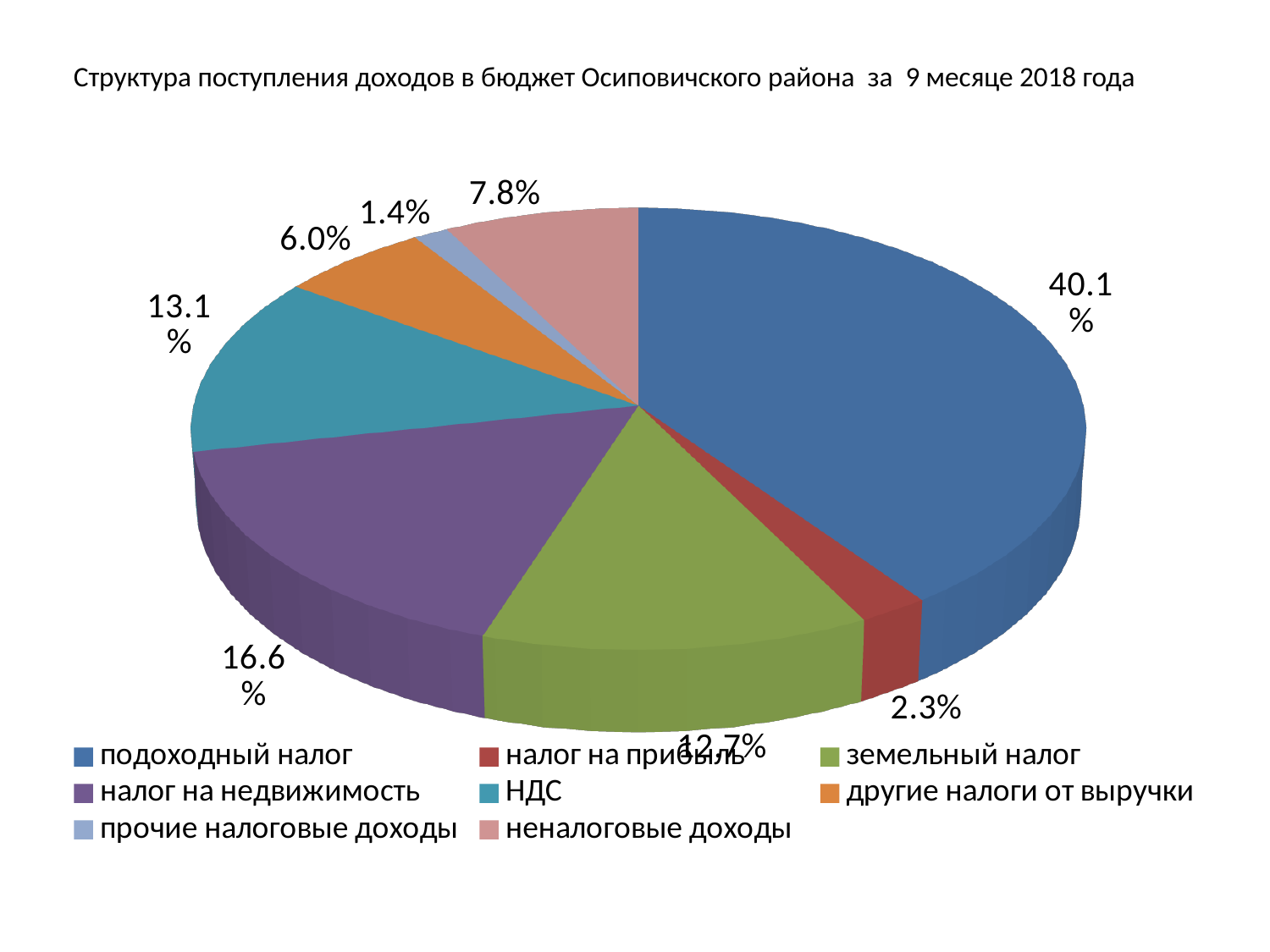
What is the difference between the share for подоходный налог and the share for налог на прибыль? 37.8% What share of the pie does неналоговые доходы have? 7.8% What share of the pie does прочие налоговые доходы have? 1.4% What share of the pie does налог на недвижимость have? 16.6% What share of the pie does НДС have? 13.1% What is the title of the chart on the slide? Структура поступления доходов в бюджет Осиповичского района за 9 месяце 2018 года Which category has the largest share of the pie? подоходный налог Which category has the smallest share of the pie? прочие налоговые доходы What share of the pie does подоходный налог have? 40.1% What kind of chart is shown on the slide? pie chart How many slices does the pie chart have? 8 Which is larger, the share for земельный налог or the share for налог на недвижимость? налог на недвижимость